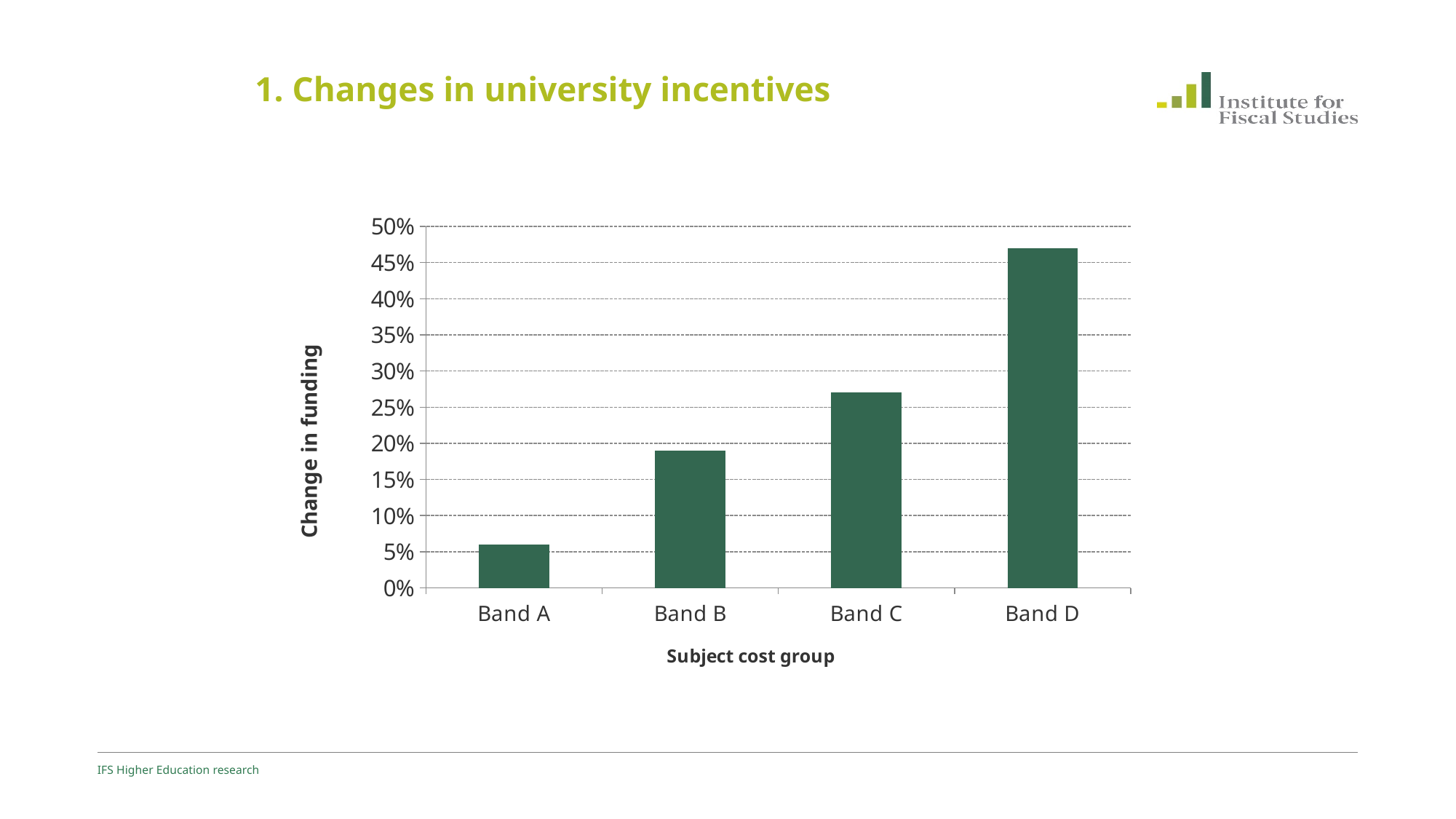
Is the change in funding for Band C greater or less than 30%? less Which subject cost group has the highest change in funding? Band D How many subject cost groups are shown on the x axis? 4 What kind of chart is shown on the slide? bar chart Is the change in funding for Band D greater or less than 45%? greater What is the label of the x axis? Subject cost group Which has a larger change in funding, Band B or Band C? Band C Is the change in funding for Band A greater or less than 10%? less Do the values rise or fall moving from Band A to Band D along the x axis? rise Which subject cost group has the lowest change in funding? Band A What is the label of the y axis? Change in funding